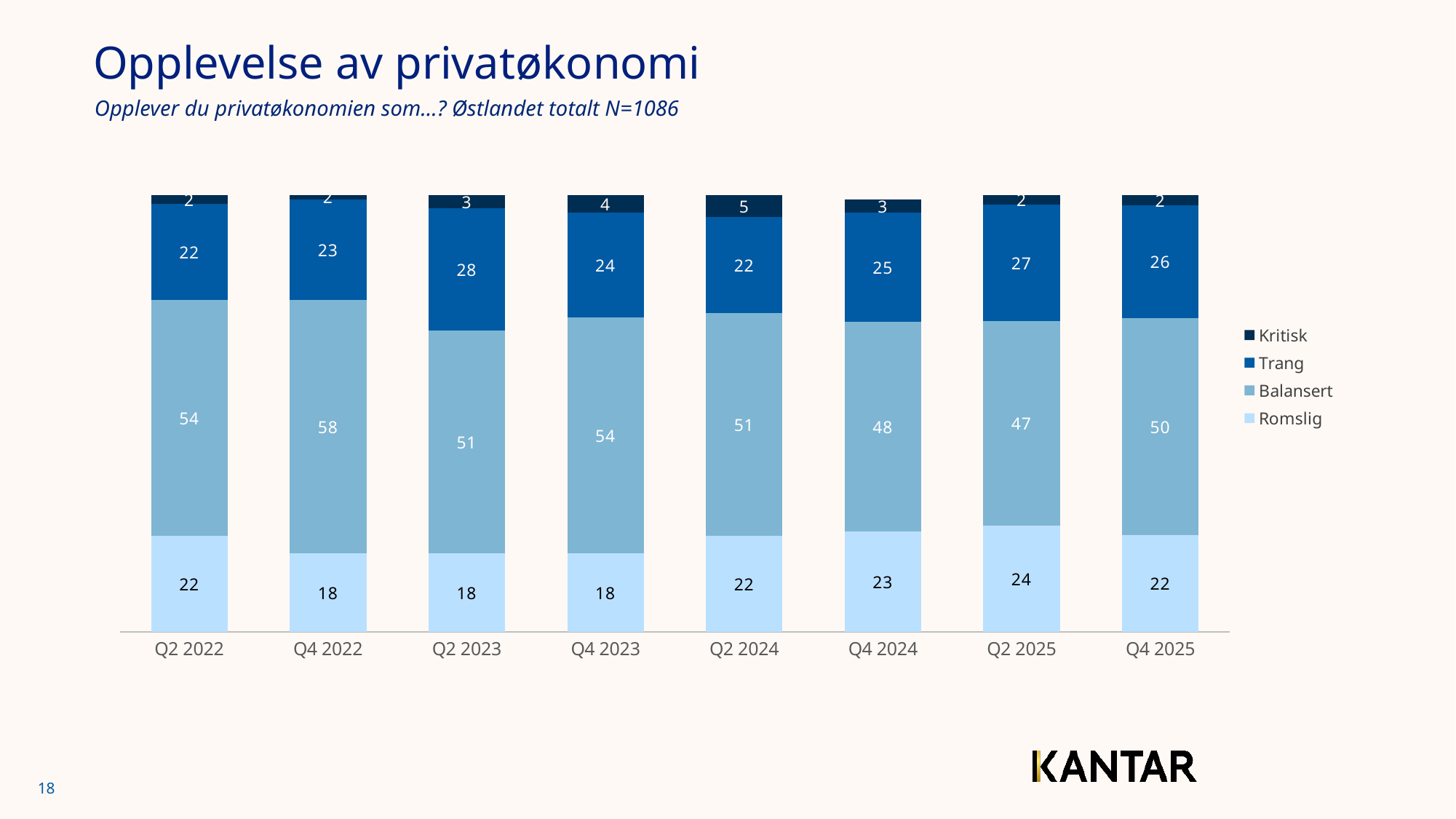
In which quarter is the Kritisk value highest? Q2 2024 What is the difference between the Balansert value in Q4 2022 and in Q2 2025? 11 What is the value for Kritisk in Q4 2023? 4 What is the value for Romslig in Q2 2025? 24 What is the value for Trang in Q4 2025? 26 In which quarter is the Balansert value lowest? Q2 2025 How many quarters are shown on the x axis? 8 What kind of chart is shown on the slide? Stacked bar chart What is the value for Balansert in Q4 2022? 58 How many series does the legend list? 4 Which is larger, the Trang value in Q2 2023 or in Q4 2023? Q2 2023 In which quarter is the Balansert value highest? Q4 2022